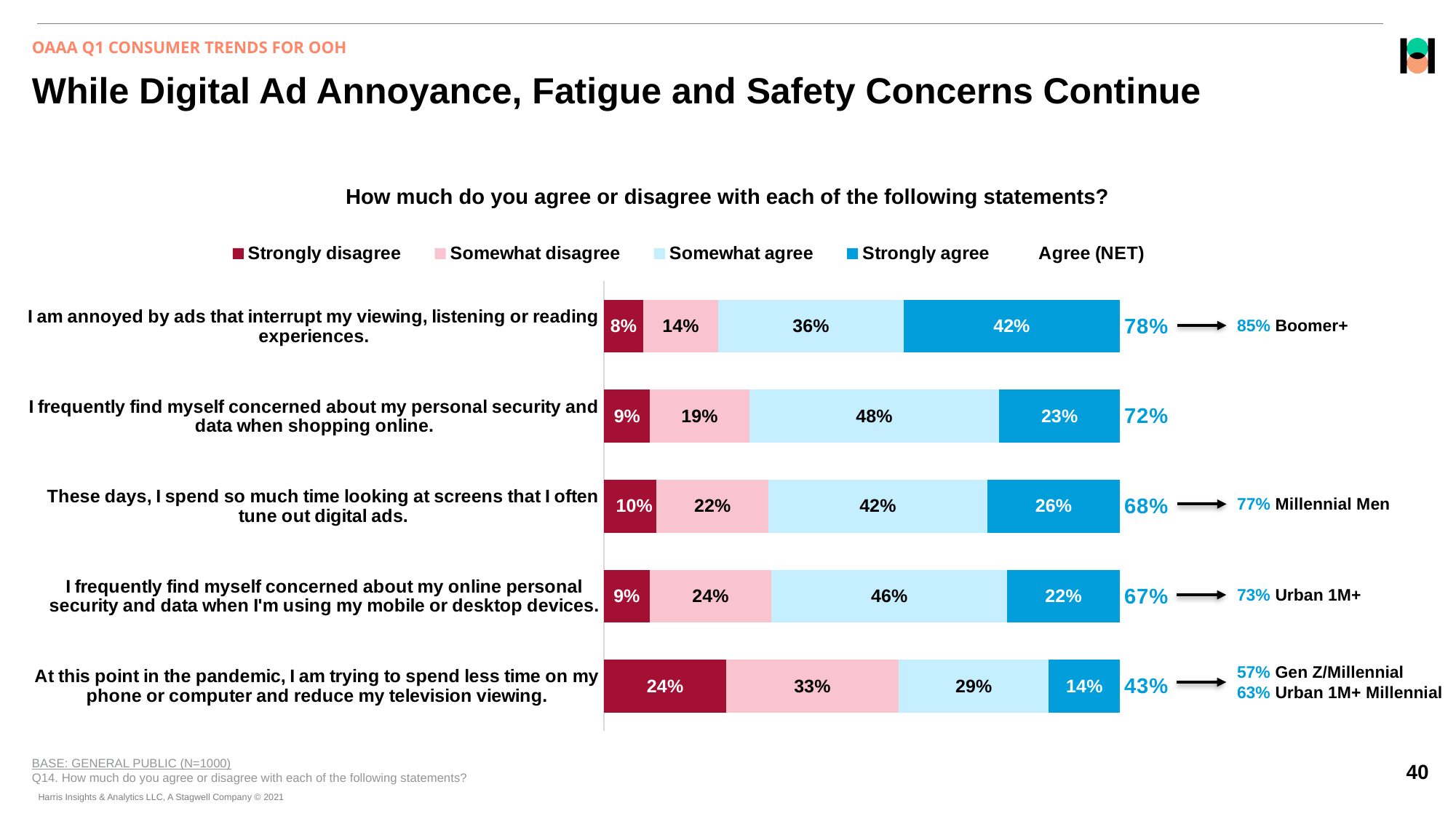
How many response categories with colour swatches does the legend list? 4 What is the Agree (NET) value for the statement "These days, I spend so much time looking at screens that I often tune out digital ads"? 68% Which statement has a larger Somewhat disagree share: the one about tuning out digital ads due to screen time, or the one about spending less time on phone or computer during the pandemic? At this point in the pandemic, I am trying to spend less time on my phone or computer and reduce my television viewing. According to the annotation, what percentage of Boomer+ agree with the statement about being annoyed by ads that interrupt viewing, listening or reading experiences? 85% What percentage somewhat agree with the statement "I frequently find myself concerned about my personal security and data when shopping online"? 48% How many percentage points higher is the Strongly agree share for the statement about being annoyed by interrupting ads than for the statement about spending less time on phone or computer during the pandemic? 28 percentage points How many statements are shown in the chart? 5 Which statement has the highest Agree (NET) value? I am annoyed by ads that interrupt my viewing, listening or reading experiences. What percentage strongly disagree with the statement about trying to spend less time on my phone or computer and reduce television viewing? 24% Which statement has the lowest Agree (NET) value? At this point in the pandemic, I am trying to spend less time on my phone or computer and reduce my television viewing. What type of chart is shown on the slide? Stacked bar chart What percentage strongly agree with the statement "I am annoyed by ads that interrupt my viewing, listening or reading experiences"? 42%